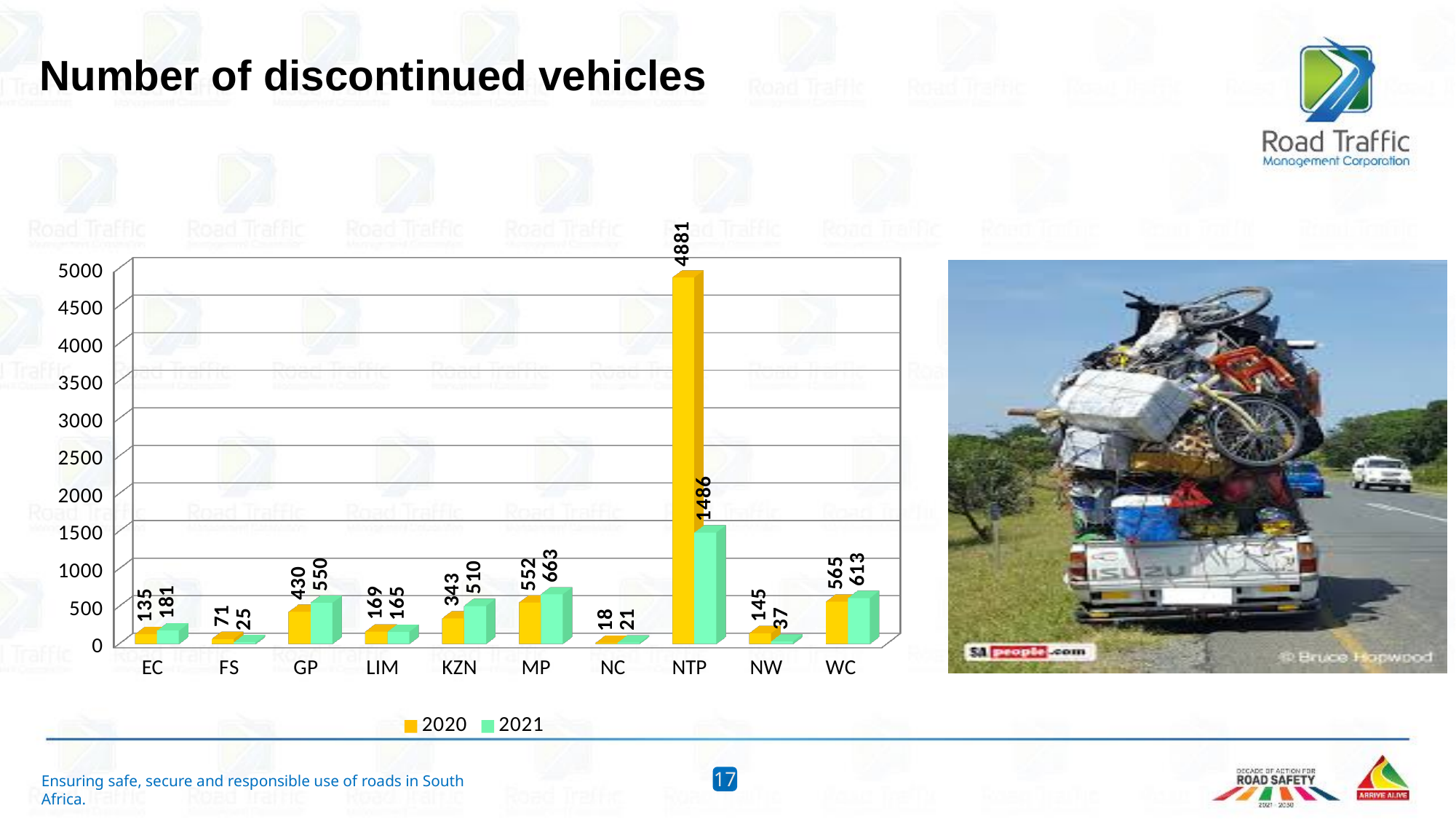
What is the value for KZN in 2021? 510 Which is larger for FS: the 2020 value or the 2021 value? 2020 What is the difference between the 2020 and 2021 values for NTP? 3395 What is the difference between the 2021 values for MP and GP? 113 What kind of chart is shown on the slide? bar chart How many provinces are shown on the x axis? 10 Is the 2021 value for NTP greater or less than 1000? greater What is the value for NW in 2020? 145 Which province has the lowest value in 2020? NC Which province has the highest value in 2021? NTP How many series does the legend list? 2 What is the value for NTP in 2020? 4881